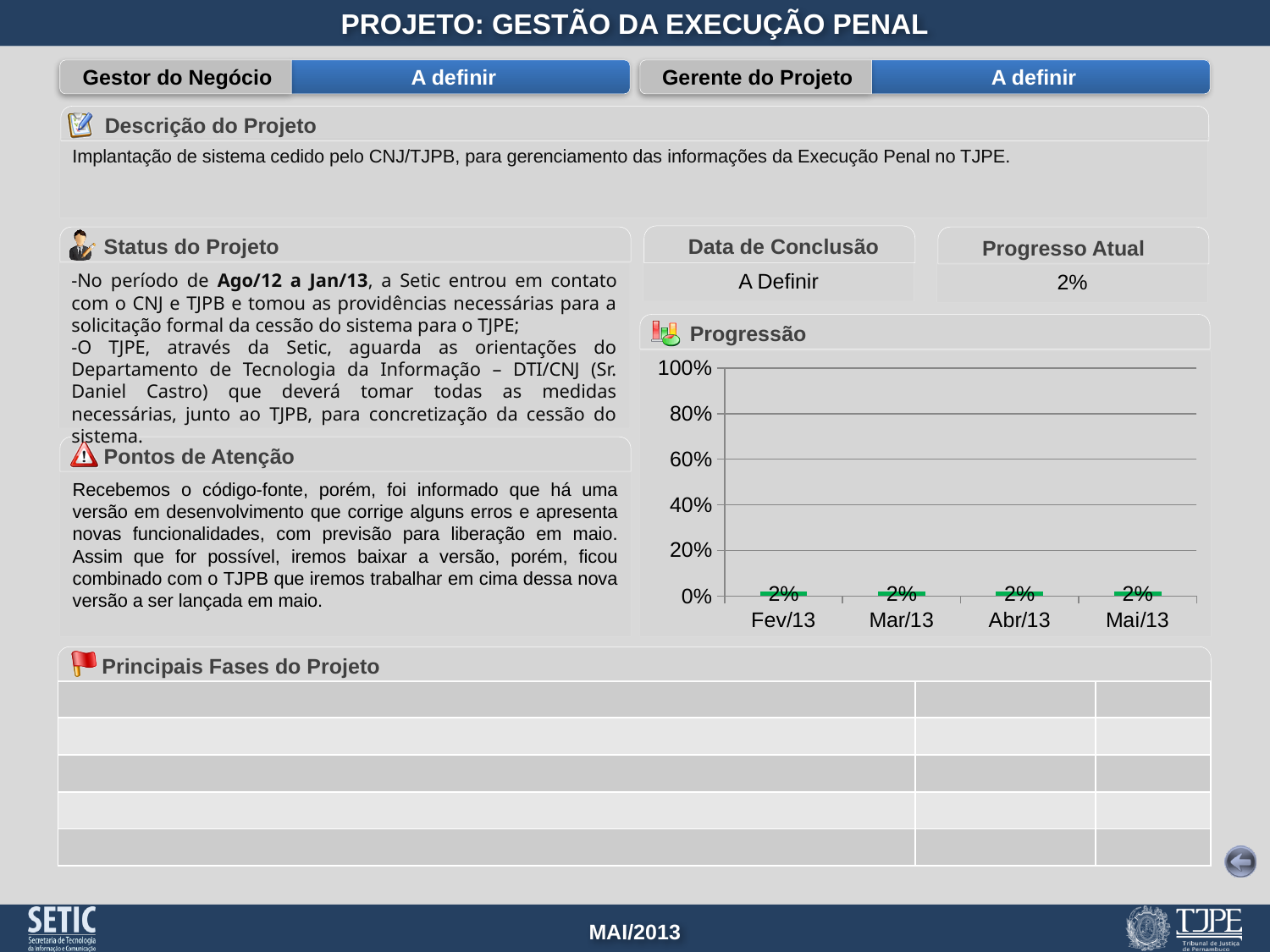
What kind of chart is the Progressão chart? bar chart What is the value for Mai/13 in the Progressão chart? 2% What is the value for Mar/13 in the Progressão chart? 2% What is the difference between the values for Fev/13 and Mai/13 in the Progressão chart? 0% Do the values in the Progressão chart rise, fall or stay flat from Fev/13 to Mai/13? stay flat What is the value for Abr/13 in the Progressão chart? 2% Is the value for Abr/13 in the Progressão chart greater or less than 20%? less What is the highest value shown on the y axis of the Progressão chart? 100% How many categories are shown on the x axis of the Progressão chart? 4 What is the value for Fev/13 in the Progressão chart? 2% What is the title of the chart on the slide? Progressão